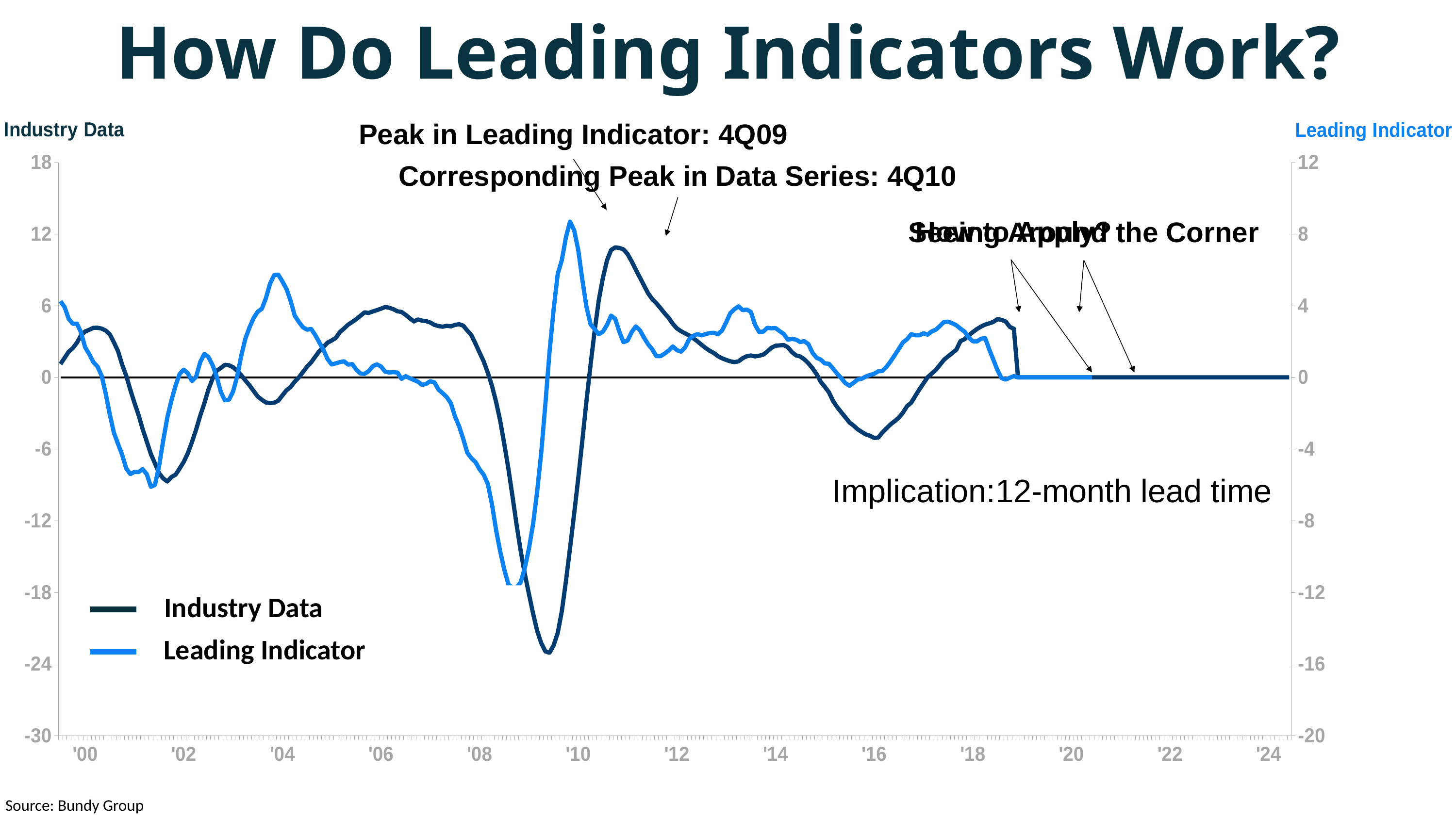
Is the peak of the Industry Data line around 2011 greater or less than 12 on the left axis? less Is the Leading Indicator value around 2004 greater or less than 4 on the right axis? greater Is the Industry Data value around 2016 greater or less than 0? less Which is lower for the Industry Data line: its trough around 2001 or its trough around 2009? Trough around 2009 What kind of chart is shown on the slide? Line chart Which is higher for the Industry Data line: its peak around 2006 or its peak around 2011? Peak around 2011 How many series does the legend list? 2 According to the annotation, in which quarter did the Leading Indicator peak? 4Q09 What are the two series named in the legend? Industry Data and Leading Indicator